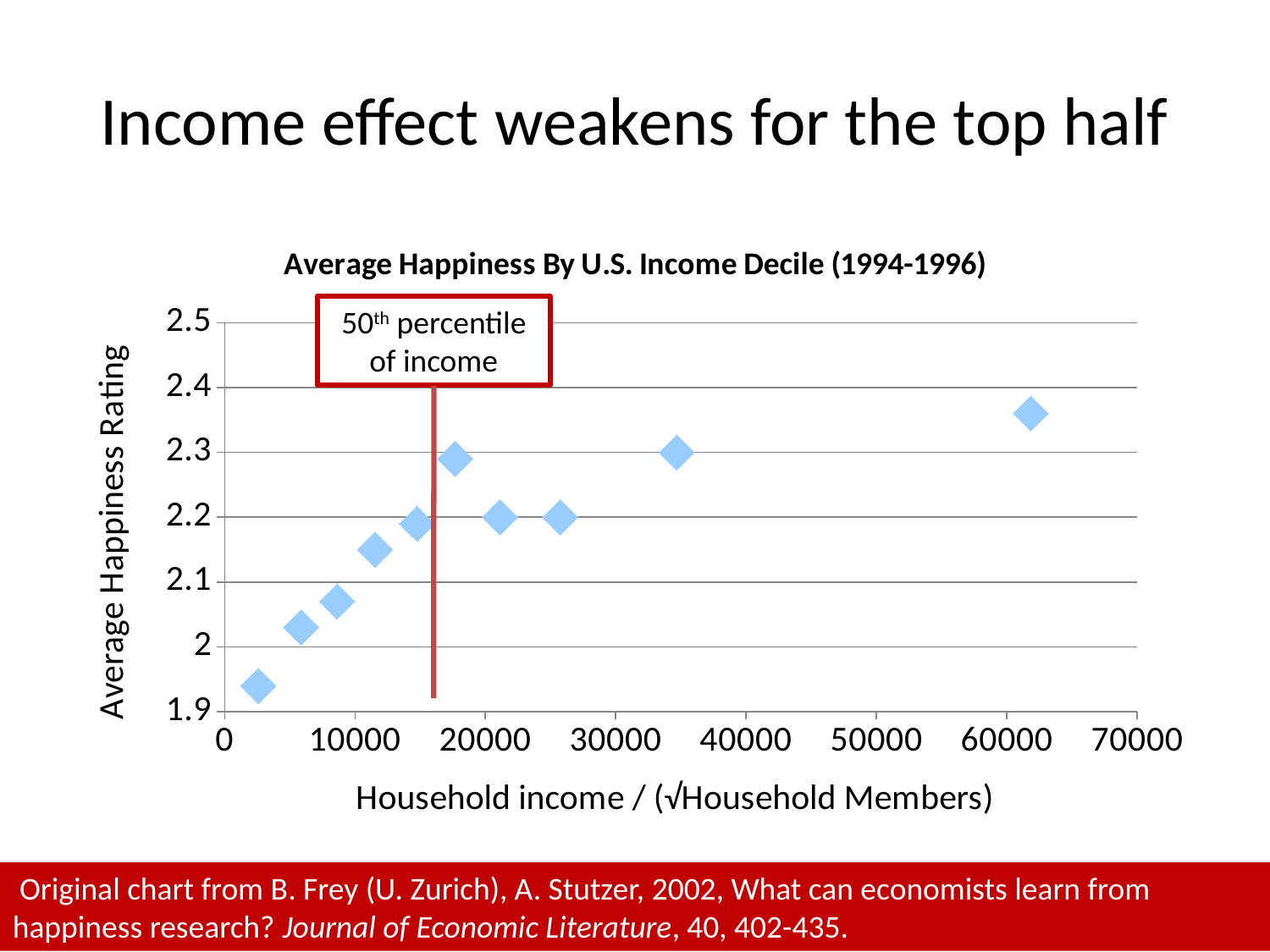
Do the happiness ratings generally rise or fall as household income increases along the x axis? rise Is the happiness rating for the leftmost point (lowest income) greater or less than 2? less Is the happiness rating for the point near 12000 on the x axis greater or less than 2.2? less How many data points are plotted on the chart? 10 What is the title of the chart? Average Happiness By U.S. Income Decile (1994-1996) Which point has the highest average happiness rating: the one at the lowest income or the one at the highest income? the one at the highest income Is the happiness rating for the rightmost point (highest income) greater or less than 2.3? greater Which point has the lowest average happiness rating: the leftmost or the rightmost? the leftmost Is the happiness rating at the lowest income decile higher or lower than at the highest income decile? lower What text appears in the red-bordered annotation box above the vertical red line? 50th percentile of income What kind of chart is shown on the slide? scatter chart